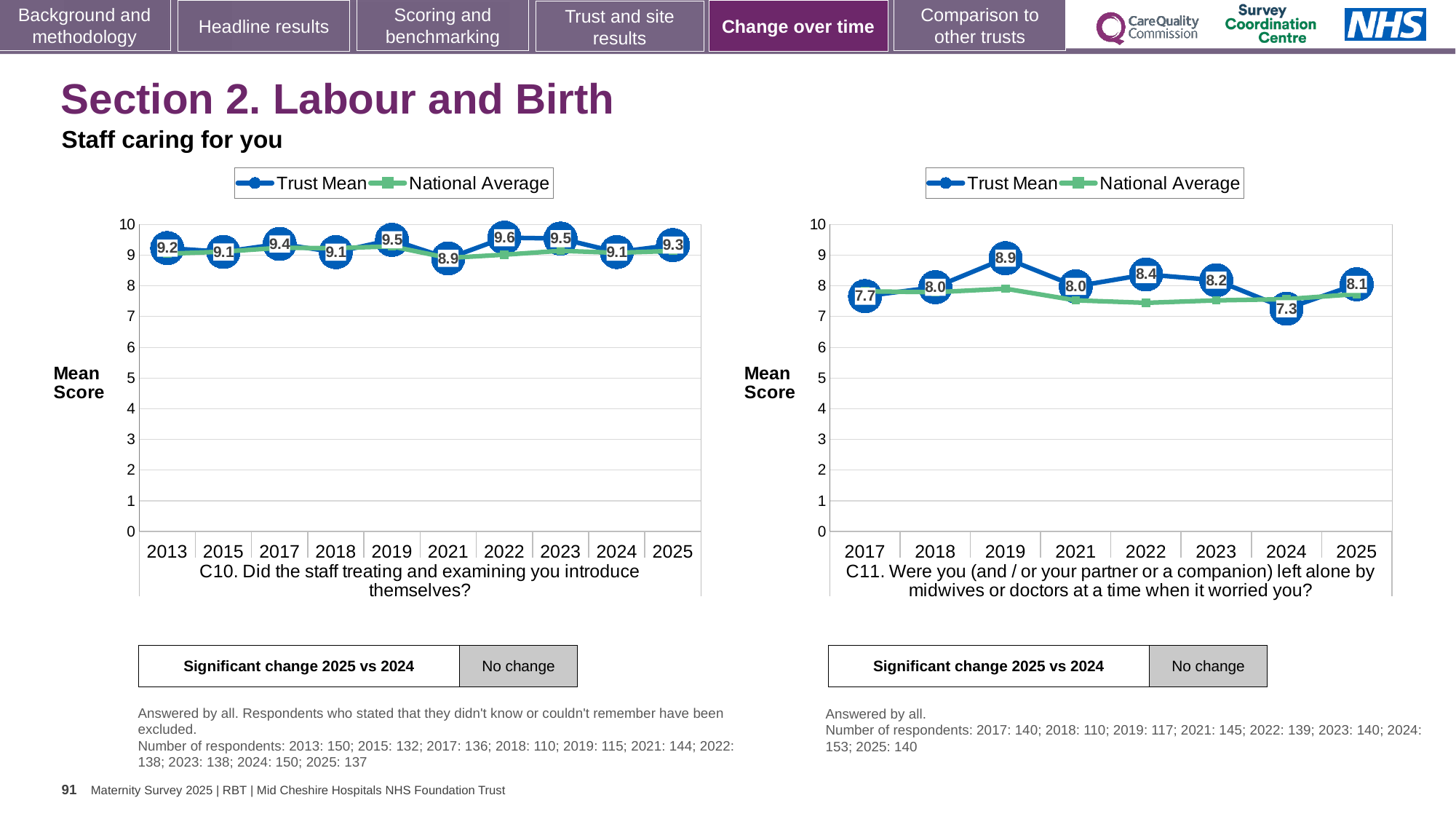
In the C11 chart on the right, which year has the lowest Trust Mean score? 2024 In the C11 chart on the right, what is the Trust Mean score for 2019? 8.9 In the C11 chart on the right, which year has the highest Trust Mean score? 2019 In the C11 chart on the right, is the Trust Mean score higher in 2022 or in 2023? 2022 In the C10 chart on the left, which year has the lowest Trust Mean score? 2021 What kind of chart is the C10 chart on the left? Line chart In the C11 chart on the right, is the National Average value for 2024 greater or less than 7? greater In the C11 chart on the right, what is the difference between the Trust Mean scores for 2025 and 2024? 0.8 How many series does the legend of the C11 chart on the right list? 2 In the C10 chart on the left, what is the difference between the Trust Mean scores for 2022 and 2021? 0.7 In the C10 chart on the left, what is the Trust Mean score for 2022? 9.6 How many years are plotted on the x axis of the C10 chart on the left? 10